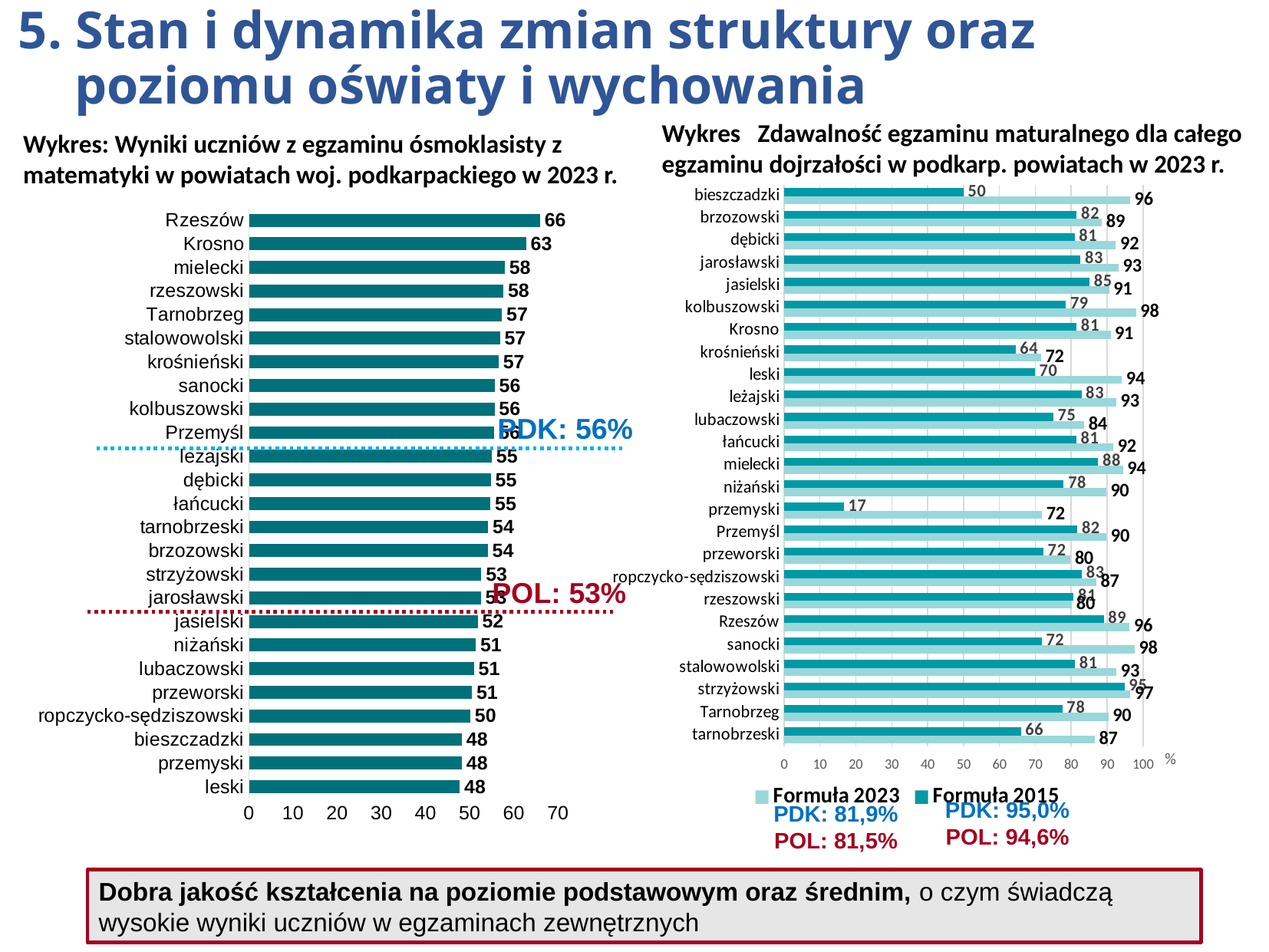
In the left chart (egzamin ósmoklasisty z matematyki), which powiat has the highest value? Rzeszów In the left chart (egzamin ósmoklasisty z matematyki), what is the lowest value shown? 48 In the left chart (egzamin ósmoklasisty z matematyki), what is the value for Rzeszów? 66 How many series does the legend of the right chart (Zdawalność egzaminu maturalnego) list? 2 In the left chart (egzamin ósmoklasisty z matematyki), what is the value for Krosno? 63 What are the two legend entries in the right chart (Zdawalność egzaminu maturalnego)? Formuła 2023 and Formuła 2015 How many powiats are listed in the left chart (egzamin ósmoklasisty z matematyki)? 25 In the left chart (egzamin ósmoklasisty z matematyki), which has the larger value, mielecki or jasielski? mielecki In the left chart (egzamin ósmoklasisty z matematyki), what is the difference between the values for Rzeszów and leski? 18 In the left chart (egzamin ósmoklasisty z matematyki), what is the value for ropczycko-sędziszowski? 50 What kind of chart is the left chart, 'Wyniki uczniów z egzaminu ósmoklasisty z matematyki'? bar chart In the right chart (Zdawalność egzaminu maturalnego), what is the lower of the two values shown for przemyski? 17